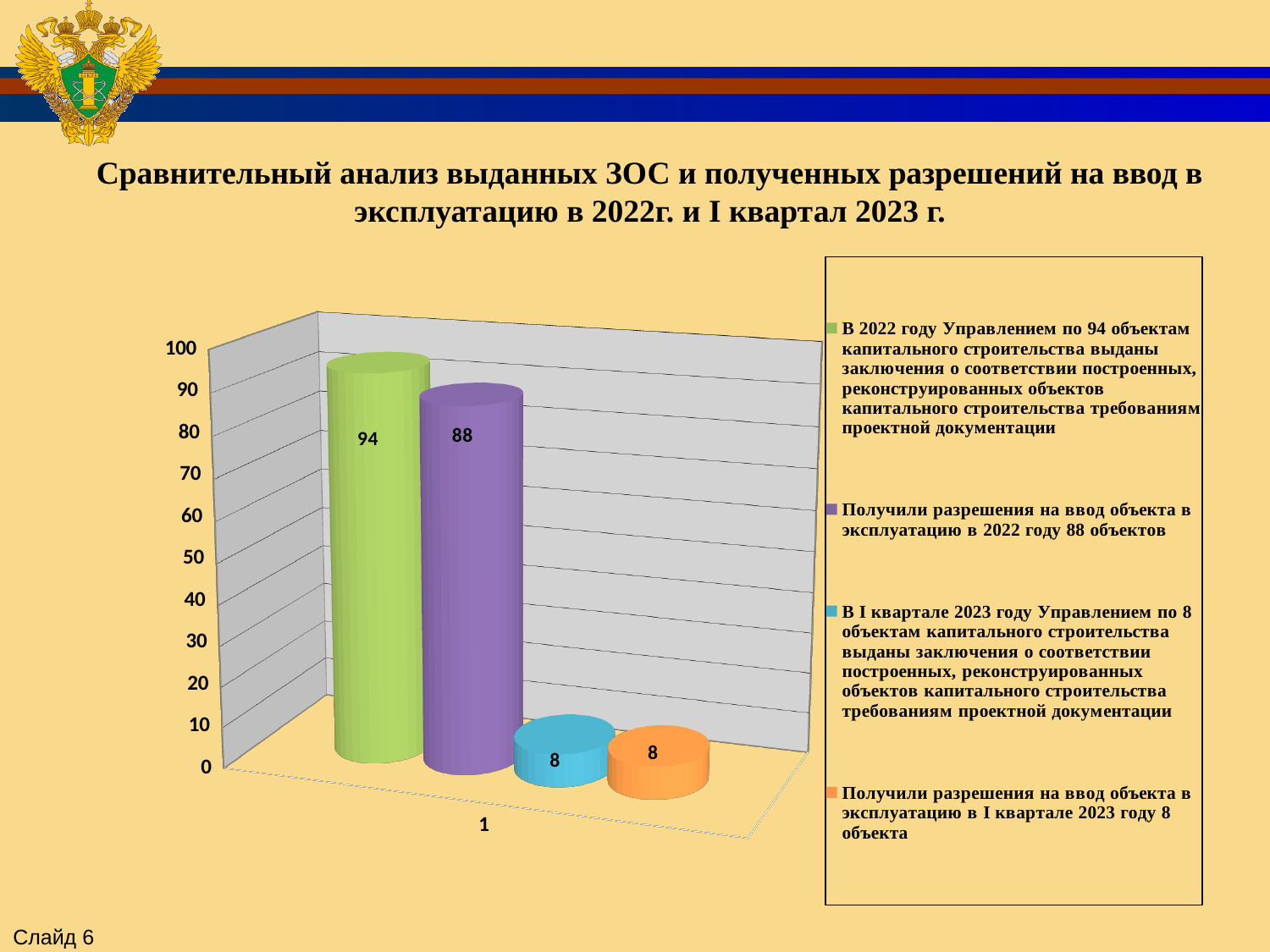
Which series has the highest value? В 2022 году Управлением по 94 объектам капитального строительства выданы заключения о соответствии (green bar) What is the maximum value shown on the vertical axis? 100 Which is larger: the value for ЗОС issued in 2022 or the value for permits received in 2022? ЗОС issued in 2022 (94) How many series does the legend list? 4 What is the value of the purple bar (permits for commissioning received in 2022)? 88 What is the lowest value shown in the chart? 8 What is the value of the orange bar (permits for commissioning received in the I quarter of 2023)? 8 What is the difference between the green bar (94) and the purple bar (88)? 6 What type of chart is shown on the slide? bar chart What is the value of the green bar (ЗОС issued for capital construction objects in 2022)? 94 What is the value of the blue bar (ЗОС issued in the I quarter of 2023)? 8 Is the value of the purple bar greater or less than 80? greater